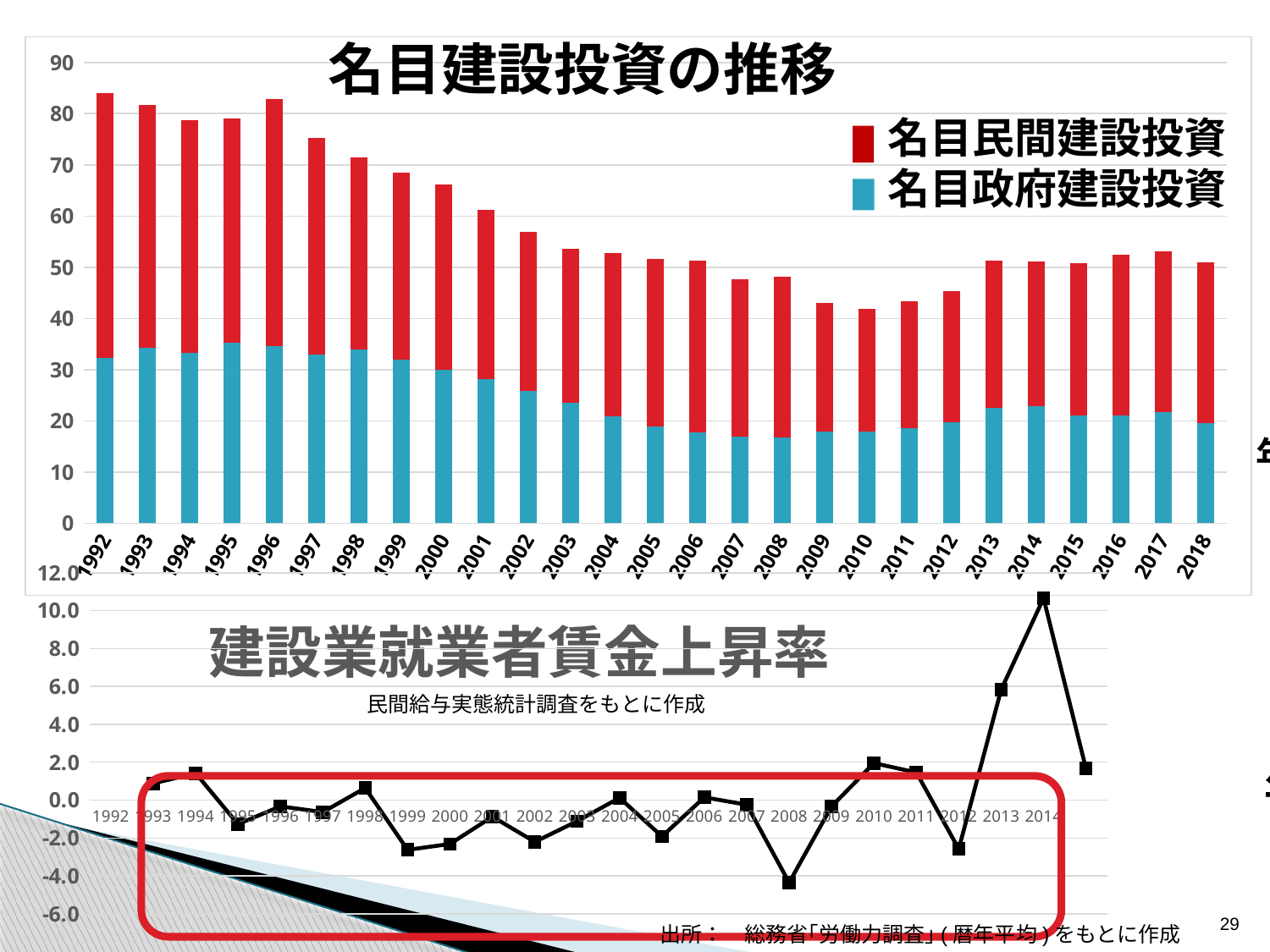
In the top chart (名目建設投資の推移), which total bar is larger, 1992 or 2018? 1992 In the top chart (名目建設投資の推移), is the total bar for 1992 greater or less than 80? greater In the top chart (名目建設投資の推移), is the 名目政府建設投資 value for 2008 greater or less than 20? less In the top chart (名目建設投資の推移), is the total bar for 2010 greater or less than 50? less In the top chart (名目建設投資の推移), which series is shown in red? 名目民間建設投資 What kind of chart is the bottom chart titled 建設業就業者賃金上昇率? Line chart In the bottom chart (建設業就業者賃金上昇率), which year has the lowest value? 2008 In the bottom chart (建設業就業者賃金上昇率), which year has the highest value? 2014 How many series does the legend of the top chart (名目建設投資の推移) list? 2 What kind of chart is the top chart titled 名目建設投資の推移? Stacked bar chart How many years are shown on the x axis of the top chart (名目建設投資の推移)? 27 In the top chart (名目建設投資の推移), do the total bars generally rise or fall from 1992 to 2010? fall